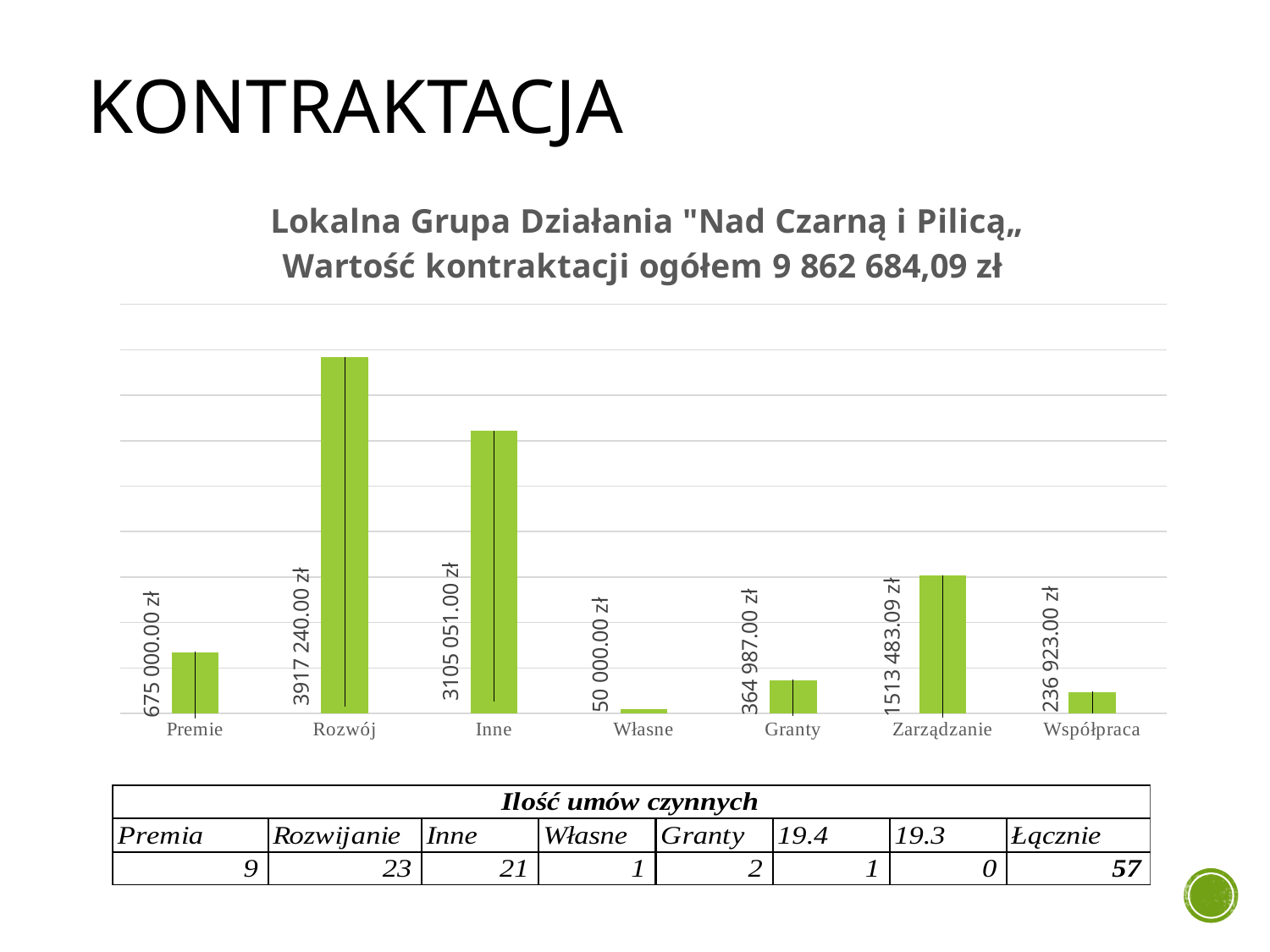
Which category has the lowest value in the chart? Własne What is the difference between the values for Premie and Własne in the chart? 625 000.00 zł Which category has the highest value in the chart? Rozwój What kind of chart is shown on the slide? bar chart What is the value for Granty in the chart? 364 987.00 zł What is the value for Rozwój in the chart? 3917 240.00 zł What is the difference between the values for Rozwój and Inne in the chart? 812 189.00 zł What is the value for Zarządzanie in the chart? 1513 483.09 zł Which is larger in the chart, the value for Premie or the value for Granty? Premie What is the value for Współpraca in the chart? 236 923.00 zł What total contract value (Wartość kontraktacji ogółem) is stated in the chart title? 9 862 684,09 zł How many categories are plotted in the chart? 7